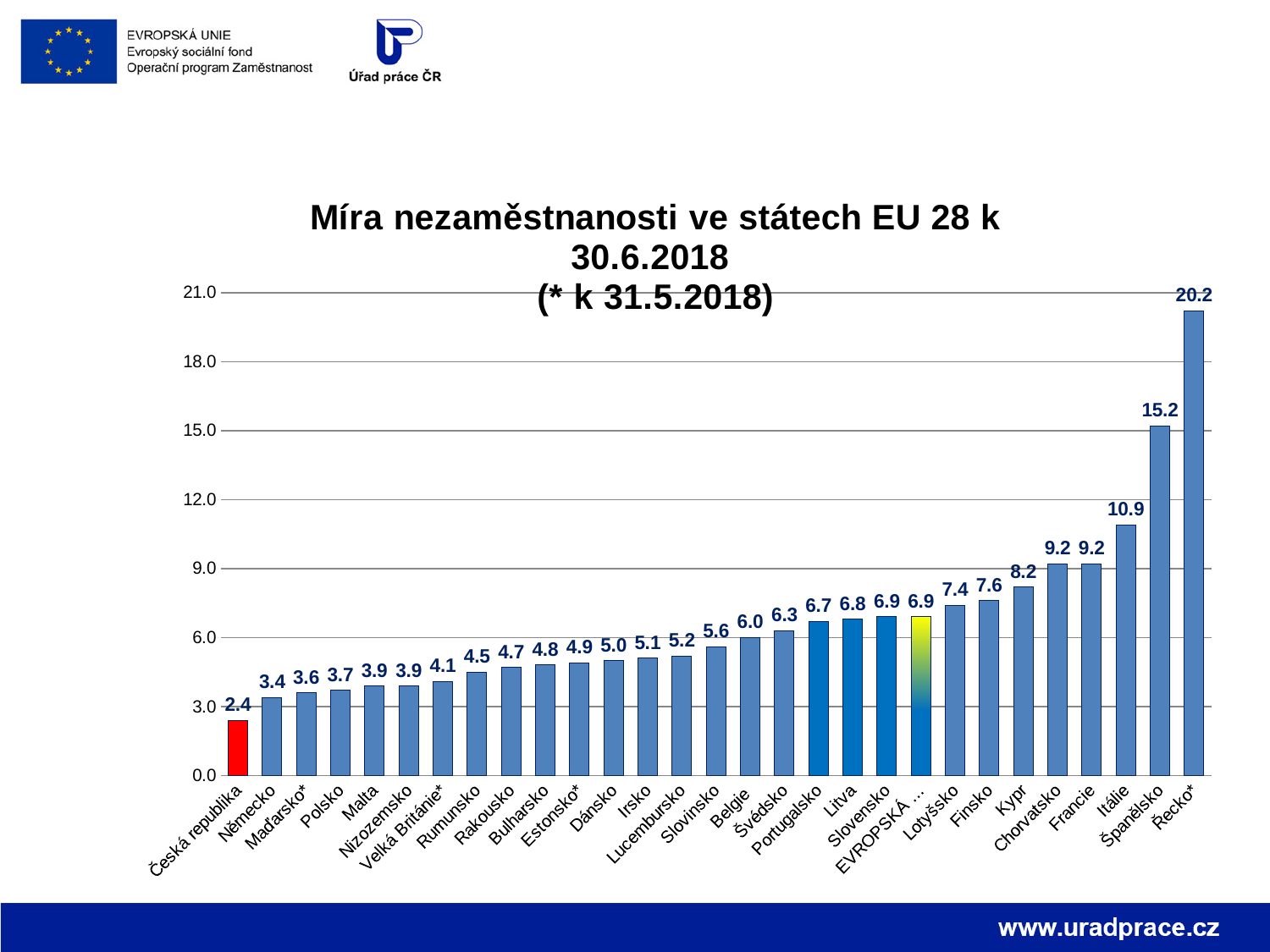
How many bars are plotted on the chart? 29 Which country has the highest unemployment rate on the chart? Řecko* What value is shown for Itálie? 10.9 Which country has the lowest unemployment rate on the chart? Česká republika Which bar is coloured red? Česká republika What type of chart is shown on the slide? bar chart What value is shown for Slovensko? 6.9 Which has a higher value, Finsko or Lotyšsko? Finsko What is the difference between the values for Řecko* and Španělsko? 5.0 Is the value for Kypr greater or less than 9.0? less What is the difference between the values for Německo and Česká republika? 1.0 What is the unemployment rate shown for Česká republika? 2.4